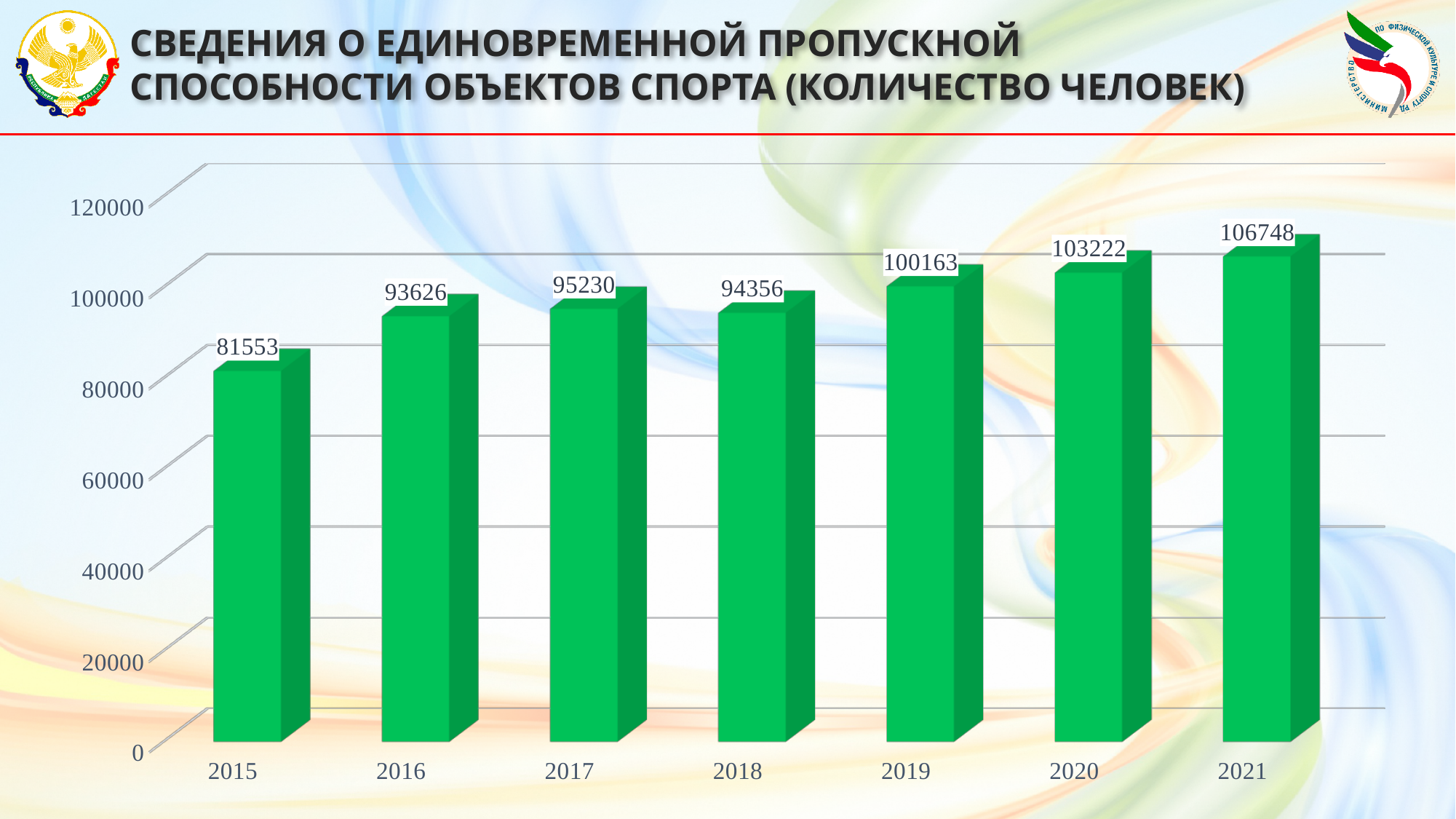
What is the value for 2015? 81553 Do the values generally rise or fall from 2015 to 2021? rise How many years are shown on the x axis? 7 Which year has the lowest value? 2015 Which is larger, the value for 2017 or the value for 2018? 2017 What is the difference between the values for 2017 and 2018? 874 Is the value for 2016 greater or less than 100000? less What is the value for 2021? 106748 Which year has the highest value? 2021 What kind of chart is shown on the slide? bar chart What is the difference between the values for 2021 and 2015? 25195 What is the value for 2019? 100163